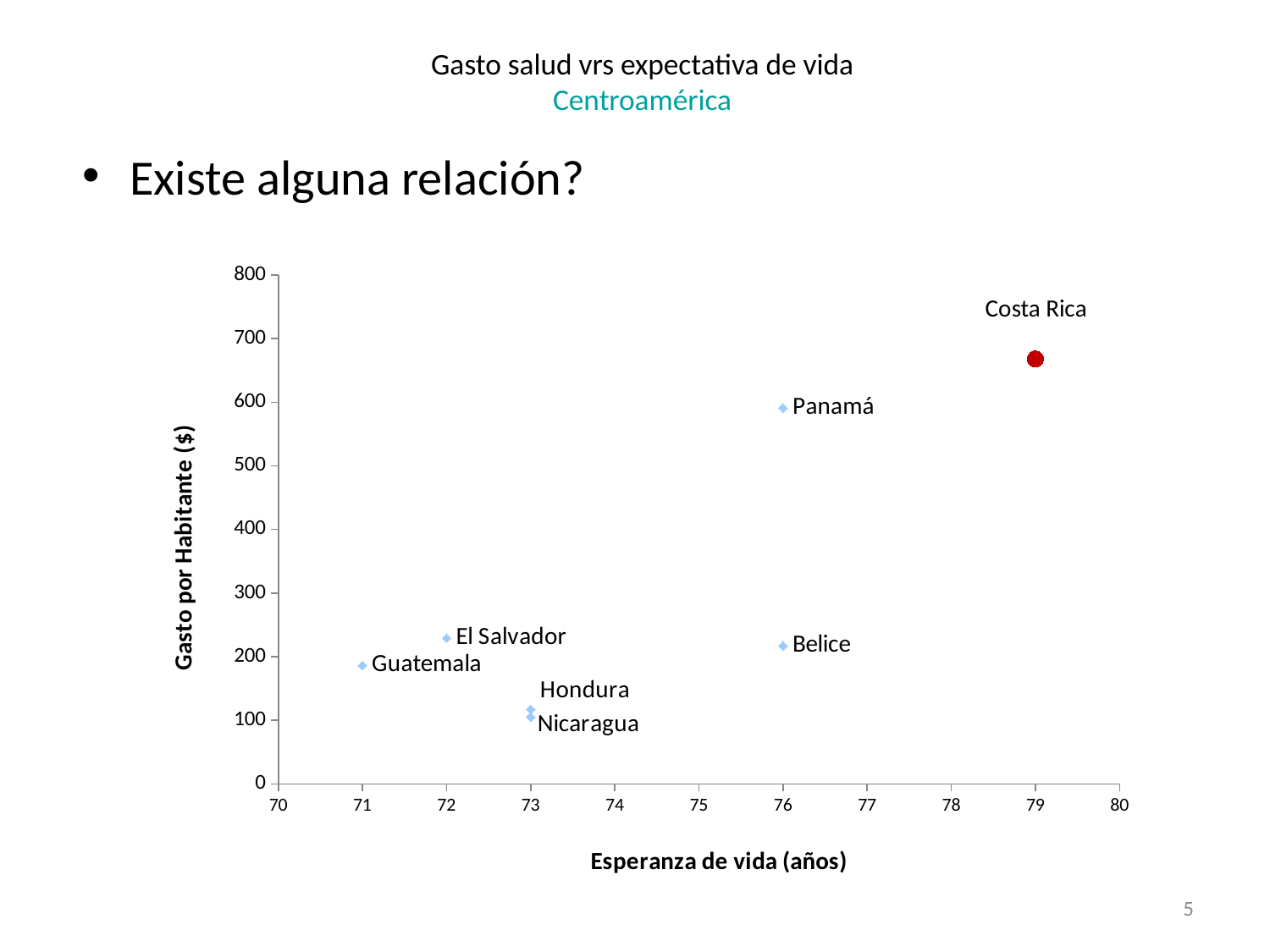
Is the Gasto por Habitante ($) for Panamá greater or less than 500? greater Which country has a higher Gasto por Habitante ($), Panamá or Belice? Panamá How many countries are plotted on the chart? 7 Which country has a higher Gasto por Habitante ($), Costa Rica or Panamá? Costa Rica What is the Esperanza de vida (años) for Panamá? 76 Which country has the highest Gasto por Habitante ($)? Costa Rica What kind of chart is shown on the slide? scatter chart What is the title of the horizontal axis of the chart? Esperanza de vida (años) What is the Esperanza de vida (años) for Costa Rica? 79 Is the Gasto por Habitante ($) for Belice greater or less than 300? less Which country has the lowest Esperanza de vida (años)? Guatemala What is the Esperanza de vida (años) for Guatemala? 71